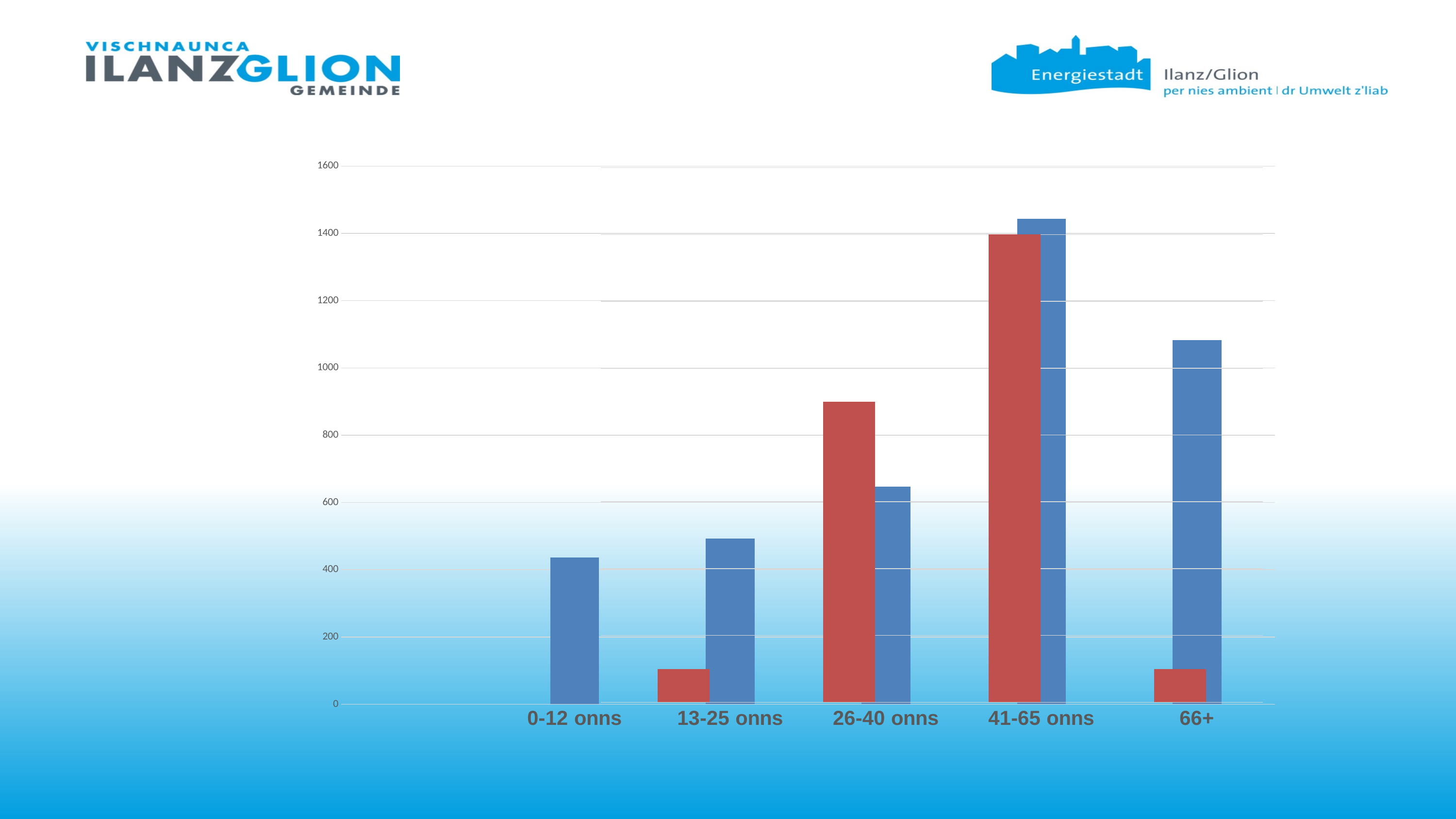
What kind of chart is shown on the slide? bar chart Is the red bar for 13-25 onns greater or less than 200? less Is the blue bar for 41-65 onns greater or less than 1400? greater Is the red bar for 26-40 onns greater or less than 800? greater For 26-40 onns, which bar is taller, the red or the blue? red For 66+, which bar is taller, the red or the blue? blue Which category has the tallest red bar? 41-65 onns Which category has the tallest blue bar? 41-65 onns How many age categories are shown on the x axis? 5 Which category has the shortest blue bar? 0-12 onns Do the blue bars rise or fall from 0-12 onns to 41-65 onns? rise